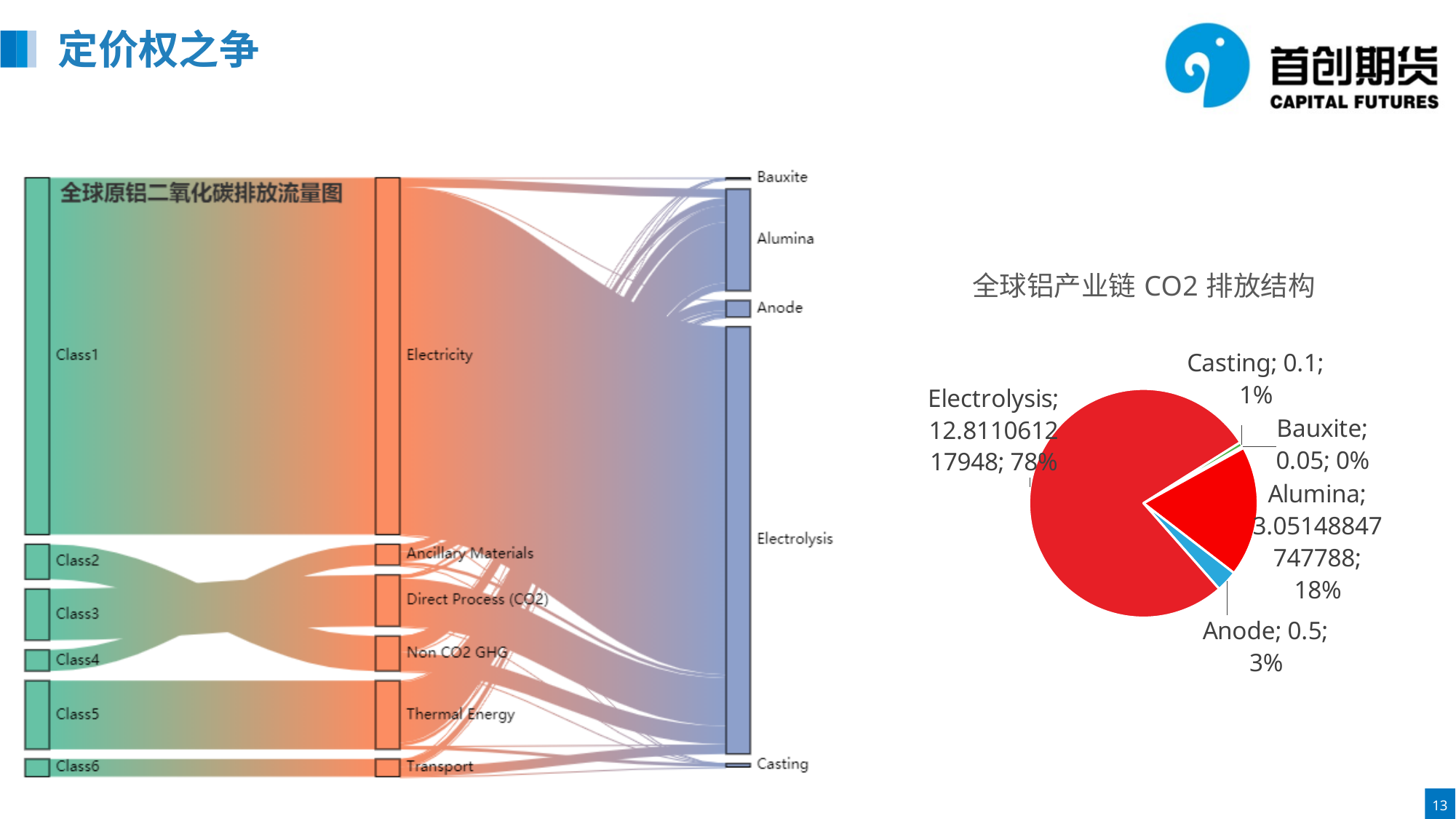
In the pie chart 全球铝产业链 CO2 排放结构, what is the difference in percentage points between the Electrolysis share and the Alumina share? 60% In the pie chart 全球铝产业链 CO2 排放结构, which has a larger share, Anode or Casting? Anode In the pie chart 全球铝产业链 CO2 排放结构, what share of emissions does Electrolysis account for? 78% What kind of chart is the chart on the right titled 全球铝产业链 CO2 排放结构? pie chart In the pie chart 全球铝产业链 CO2 排放结构, what share of emissions does Alumina account for? 18% In the pie chart 全球铝产业链 CO2 排放结构, which category has the largest share? Electrolysis In the pie chart 全球铝产业链 CO2 排放结构, how many slices are there? 5 In the pie chart 全球铝产业链 CO2 排放结构, which category has the smallest share? Bauxite In the pie chart 全球铝产业链 CO2 排放结构, what is the value shown for Anode? 0.5 In the flow chart on the left titled 全球原铝二氧化碳排放流量图, how many Class nodes are shown in the left column? 6 In the pie chart 全球铝产业链 CO2 排放结构, what is the value shown for Casting? 0.1 In the pie chart 全球铝产业链 CO2 排放结构, what is the value shown for Bauxite? 0.05